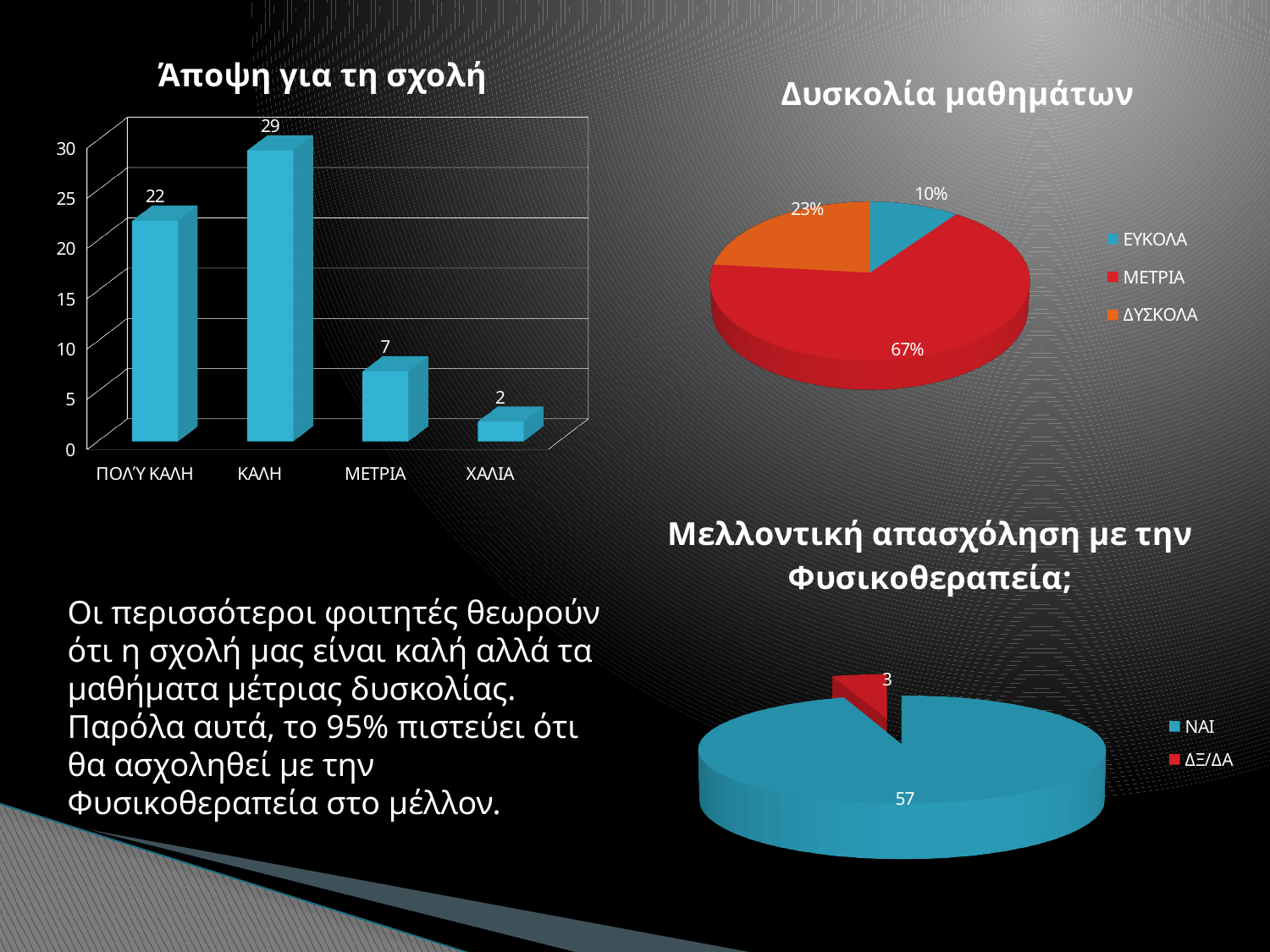
In the chart titled 'Μελλοντική απασχόληση με την Φυσικοθεραπεία;', what is the difference between the values for ΝΑΙ and ΔΞ/ΔΑ? 54 What kind of chart is the one titled 'Άποψη για τη σχολή'? Bar chart How many entries does the legend of the chart titled 'Δυσκολία μαθημάτων' list? 3 In the chart titled 'Άποψη για τη σχολή', how many categories are shown on the x axis? 4 In the chart titled 'Δυσκολία μαθημάτων', what percentage is shown for ΜΕΤΡΙΑ? 67% In the chart titled 'Άποψη για τη σχολή', what is the value for ΧΑΛΙΑ? 2 In the chart titled 'Δυσκολία μαθημάτων', which category has the smallest slice? ΕΥΚΟΛΑ In the chart titled 'Άποψη για τη σχολή', which category has the lowest value? ΧΑΛΙΑ In the chart titled 'Άποψη για τη σχολή', which category has the highest value? ΚΑΛΗ In the chart titled 'Μελλοντική απασχόληση με την Φυσικοθεραπεία;', what is the value for ΝΑΙ? 57 In the chart titled 'Άποψη για τη σχολή', what is the value for ΚΑΛΗ? 29 In the chart titled 'Άποψη για τη σχολή', what is the difference between the values for ΚΑΛΗ and ΠΟΛΎ ΚΑΛΗ? 7